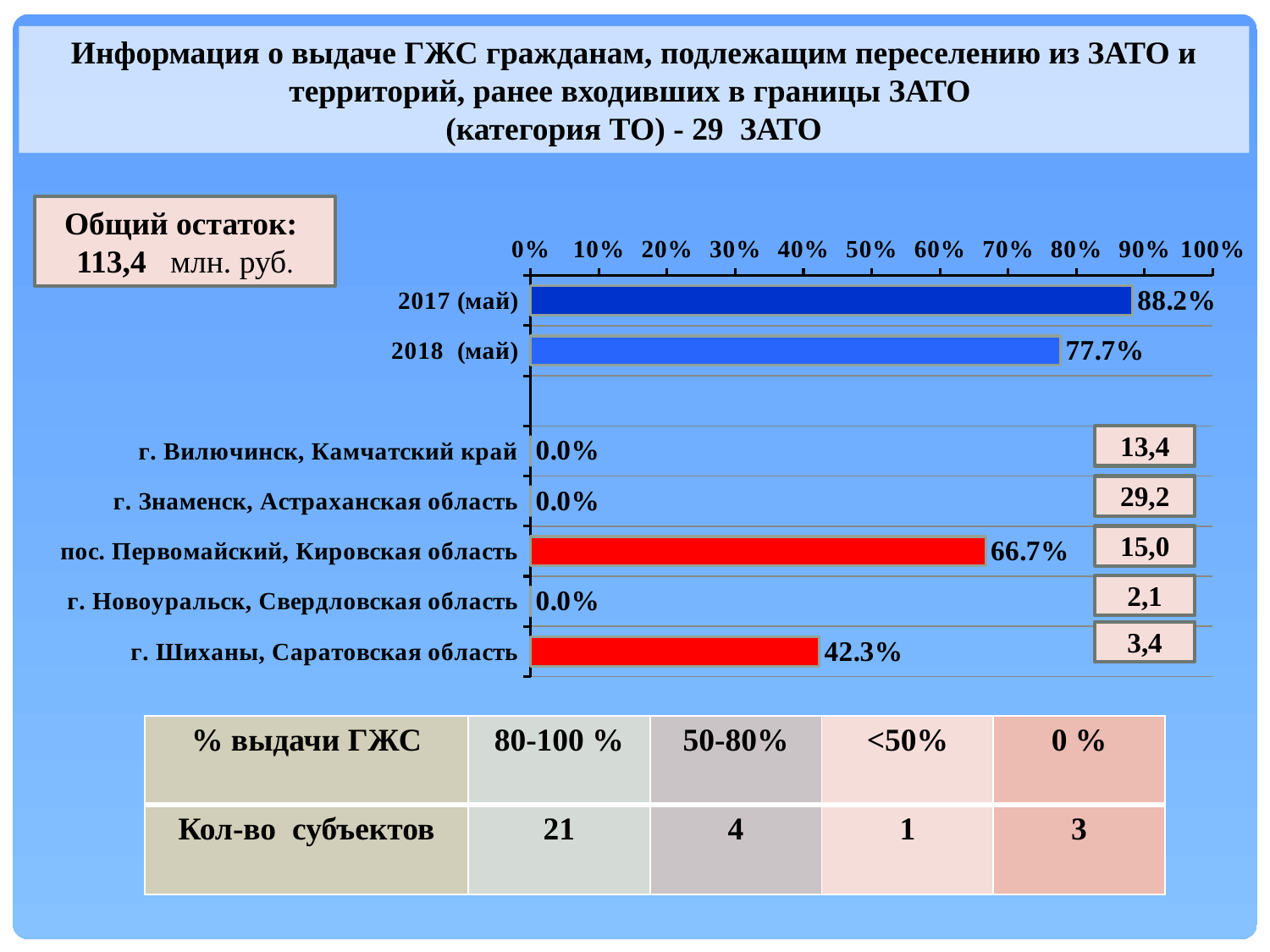
What is the value for г. Новоуральск, Свердловская область? 0.0% What is the value for г. Шиханы, Саратовская область? 42.3% How many of the listed regions have a value of 0.0%? 3 What is the value for 2017 (май)? 88.2% What is the value for 2018 (май)? 77.7% What is the difference between the values for пос. Первомайский, Кировская область and г. Шиханы, Саратовская область? 24.4% What is the difference between the values for 2017 (май) and 2018 (май)? 10.5% What kind of chart is shown on the slide? bar chart What is the highest value shown on the axis of the chart? 100% Is the value for г. Шиханы, Саратовская область greater or less than 50%? less What is the value for пос. Первомайский, Кировская область? 66.7% Which is larger, the value for пос. Первомайский, Кировская область or the value for г. Шиханы, Саратовская область? пос. Первомайский, Кировская область